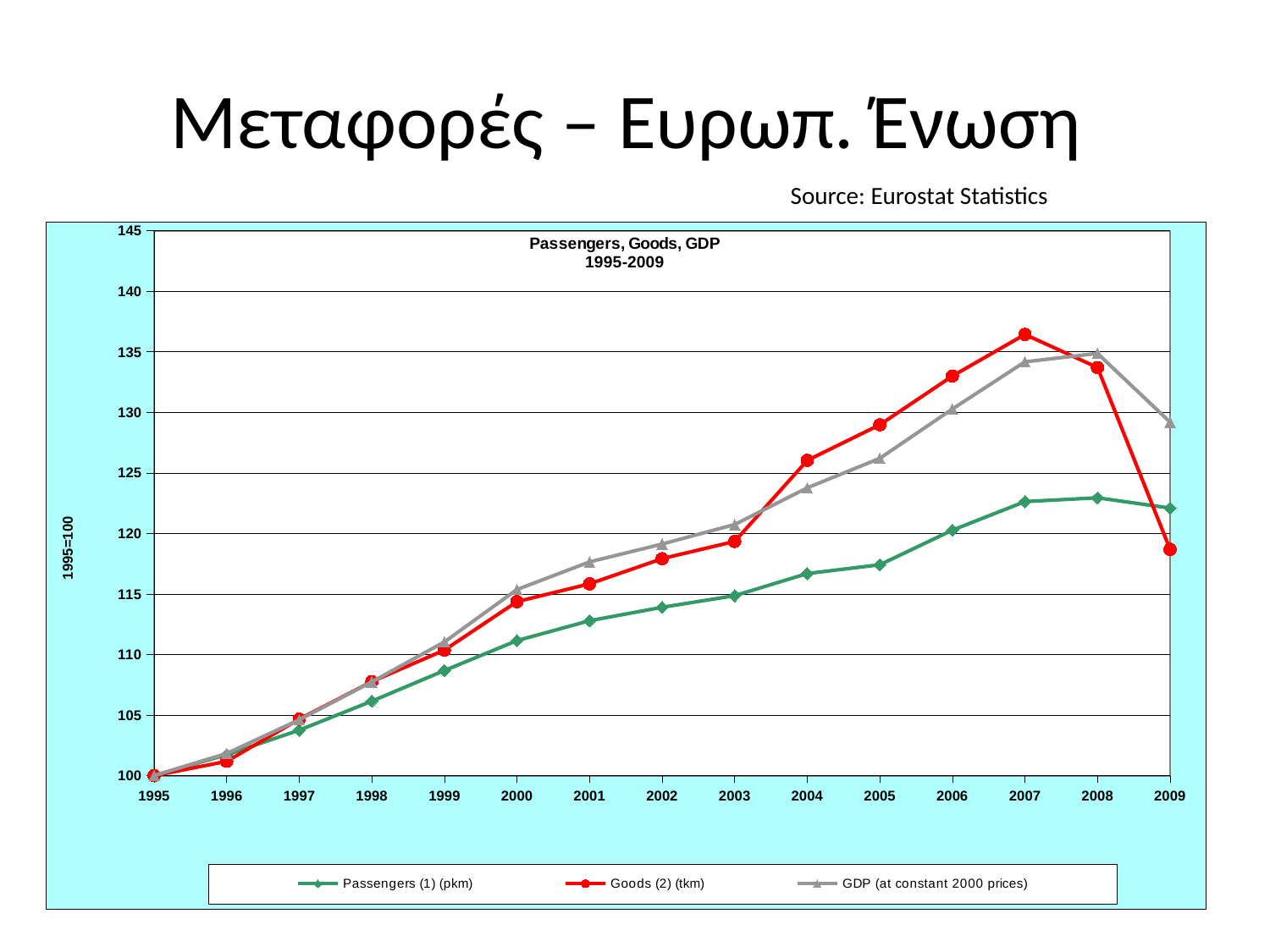
What kind of chart is shown on the slide? line chart Is the value for Goods (2) (tkm) in 2009 greater or less than 120? less What is the value of the Goods (2) (tkm) series in 1995? 100 How many series does the legend list? 3 In 2009, which is larger: the Passengers (1) (pkm) value or the Goods (2) (tkm) value? Passengers (1) (pkm) Is the value for Passengers (1) (pkm) in 2005 greater or less than 120? less What is the title of the chart? Passengers, Goods, GDP 1995-2009 Which series has the highest value in 2007? Goods (2) (tkm) Which series has the lowest value in 2009? Goods (2) (tkm) Is the value for Goods (2) (tkm) in 2007 greater or less than 135? greater Does the Goods (2) (tkm) series rise or fall from 2008 to 2009? fall How many years are plotted along the x axis? 15